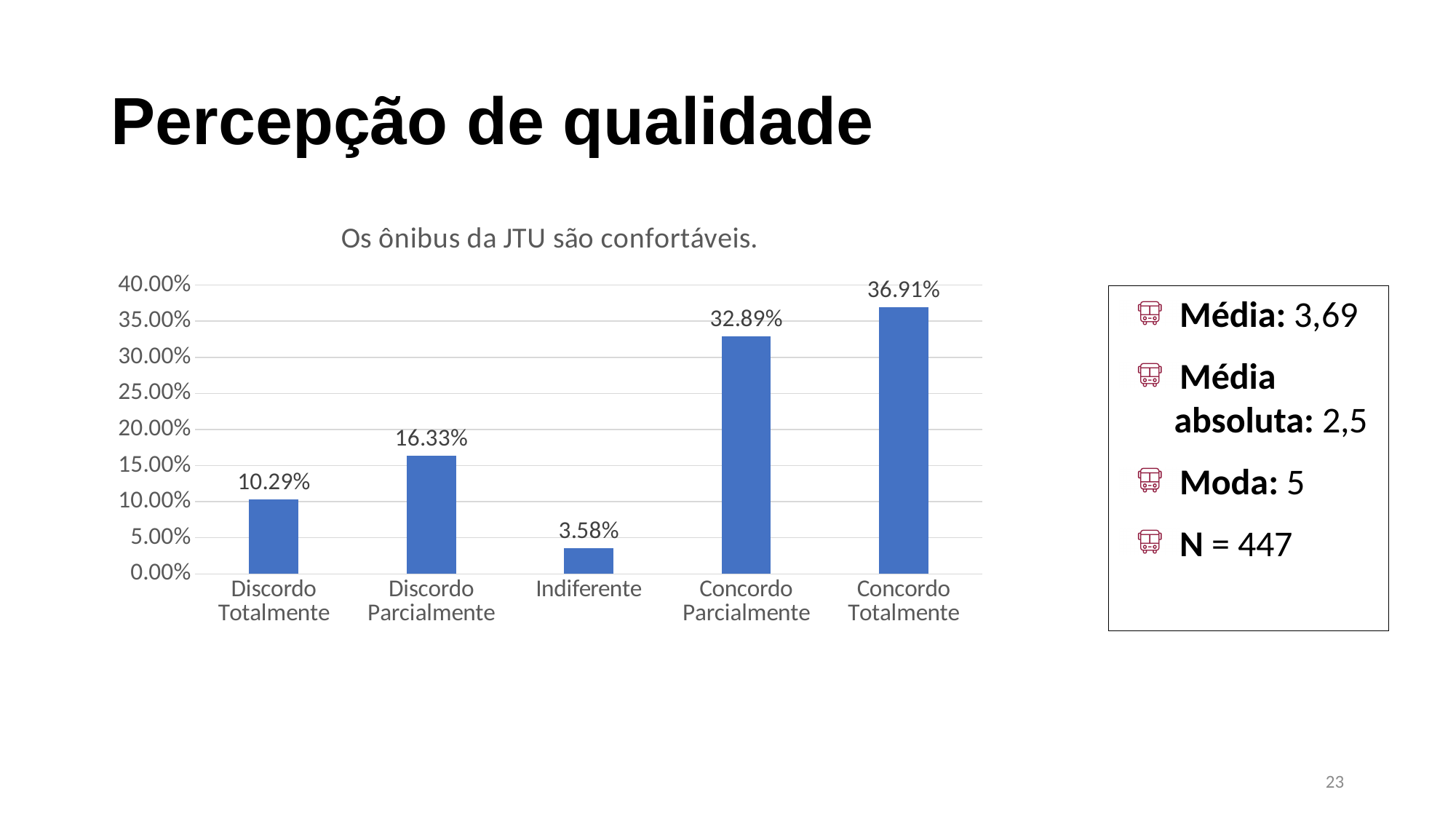
What is the difference between Concordo Totalmente and Concordo Parcialmente? 4.02% Which category has the lowest value? Indiferente Which category has the highest value? Concordo Totalmente What is the value for Indiferente? 3.58% What kind of chart is shown on the slide? bar chart What is the value for Discordo Parcialmente? 16.33% How many categories are shown on the x axis? 5 Is the value for Concordo Parcialmente greater or less than 30.00%? greater What is the difference between Discordo Parcialmente and Discordo Totalmente? 6.04% Which is larger, Discordo Totalmente or Discordo Parcialmente? Discordo Parcialmente What is the value for Concordo Totalmente? 36.91% What is the title of the chart? Os ônibus da JTU são confortáveis.